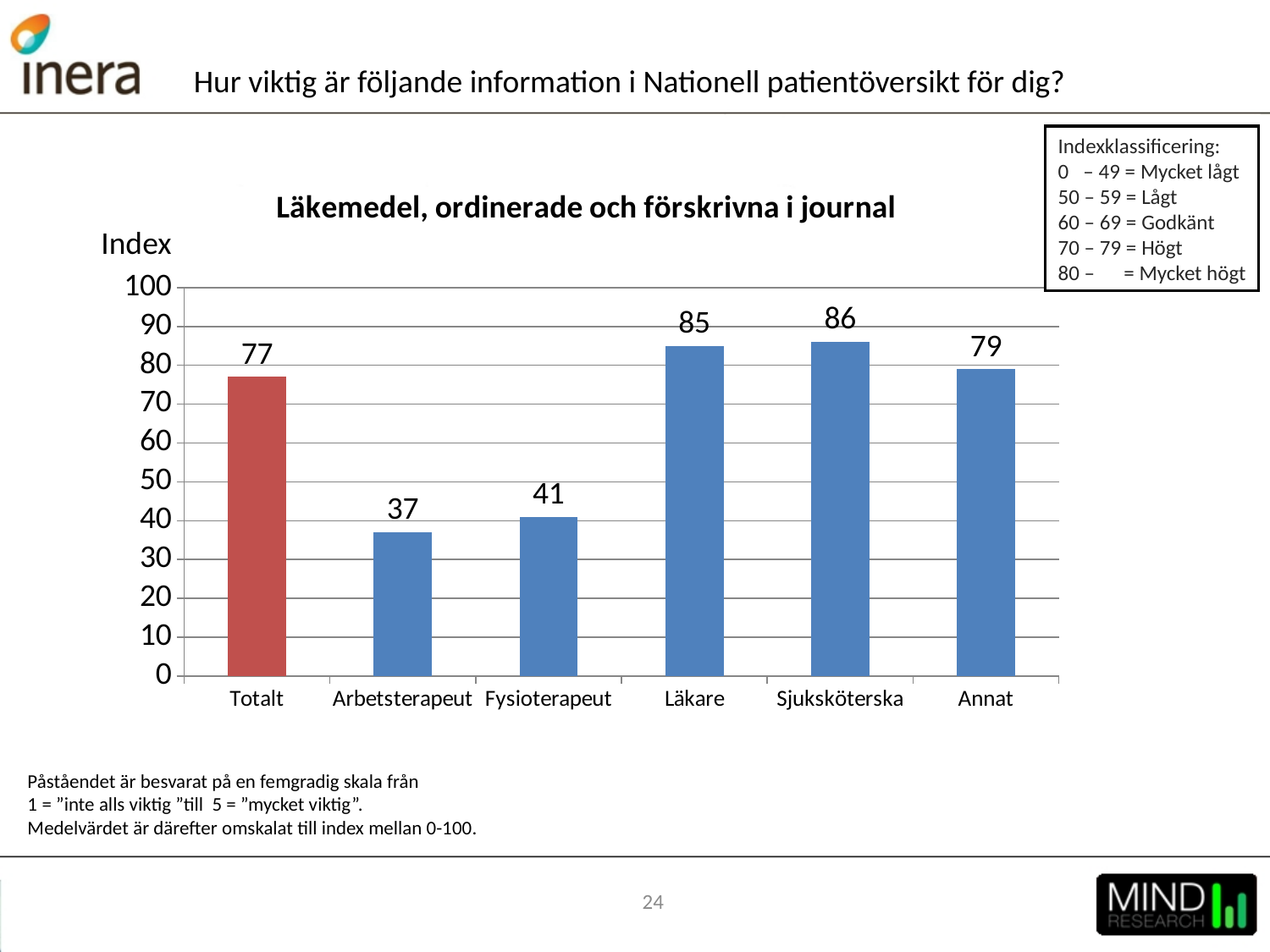
Is the value for Annat greater or less than 70? greater What kind of chart is shown on the slide? bar chart What is the index value for Läkare? 85 How many categories are shown on the x axis? 6 Which category has the lowest index value? Arbetsterapeut What is the title of the chart? Läkemedel, ordinerade och förskrivna i journal Which has a higher index value, Annat or Fysioterapeut? Annat Which category has the highest index value? Sjuksköterska Which bar is coloured red rather than blue? Totalt What is the index value for Totalt? 77 What is the difference between the index values for Läkare and Fysioterapeut? 44 What is the index value for Arbetsterapeut? 37